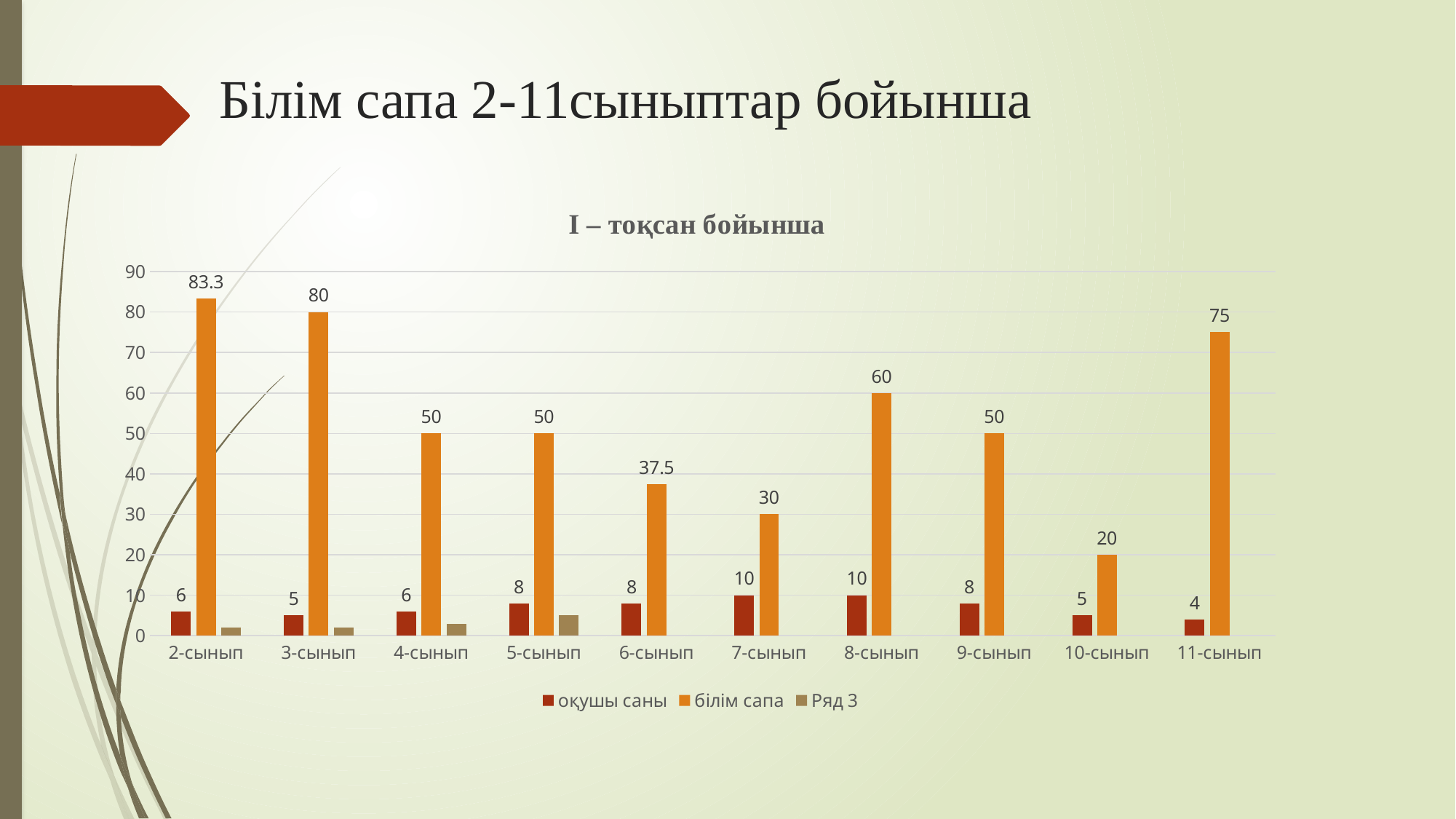
What is the value of оқушы саны for 7-сынып? 10 Which class has the highest білім сапа value? 2-сынып Is the Ряд 3 value for 5-сынып greater or less than 10? less Which is larger, the білім сапа value for 8-сынып or for 9-сынып? 8-сынып What is the difference between the білім сапа values for 3-сынып and 11-сынып? 5 What is the value of білім сапа for 2-сынып? 83.3 How many classes are shown on the x axis? 10 How many series does the legend list? 3 What is the value of білім сапа for 6-сынып? 37.5 Which class has the lowest білім сапа value? 10-сынып What is the title of the chart? I – тоқсан бойынша What kind of chart is shown? bar chart